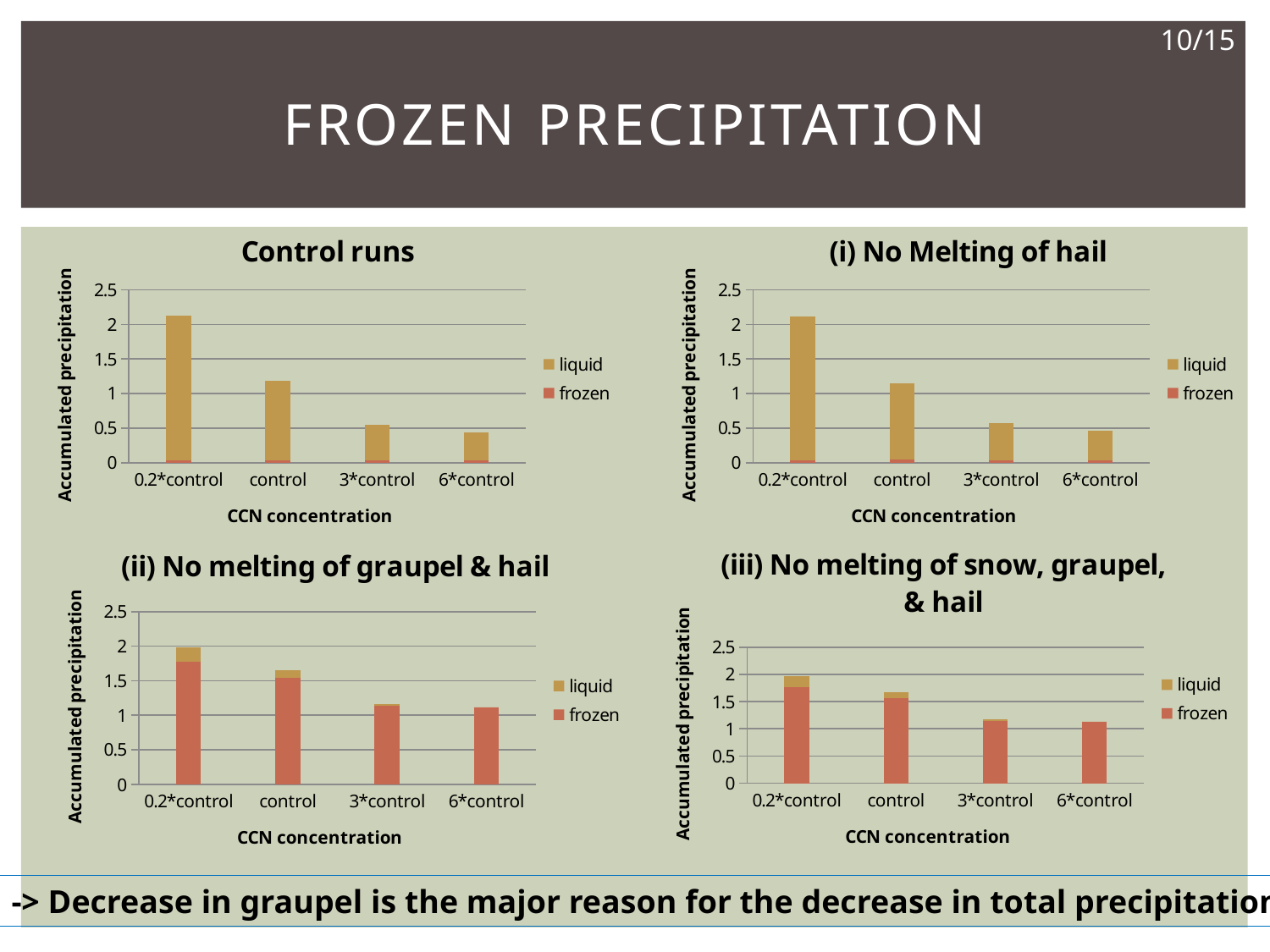
In the 'Control runs' chart, which CCN concentration has the highest accumulated precipitation? 0.2*control What kind of chart is the 'Control runs' chart? bar chart In the '(ii) No melting of graupel & hail' chart, is the accumulated precipitation for 3*control greater or less than 1? greater In the '(ii) No melting of graupel & hail' chart, which series makes up the larger part of the 0.2*control bar, liquid or frozen? frozen How many series does the legend of the 'Control runs' chart list? 2 How many CCN concentration categories are shown on the x axis of the '(i) No Melting of hail' chart? 4 In the 'Control runs' chart, is the accumulated precipitation for control greater or less than 1.5? less In the '(iii) No melting of snow, graupel, & hail' chart, which CCN concentration has the highest accumulated precipitation? 0.2*control In the 'Control runs' chart, which CCN concentration has the lowest accumulated precipitation? 6*control In the 'Control runs' chart, is the accumulated precipitation for 0.2*control greater or less than 1.5? greater In the 'Control runs' chart, do the accumulated precipitation values rise or fall from 0.2*control to 6*control? fall